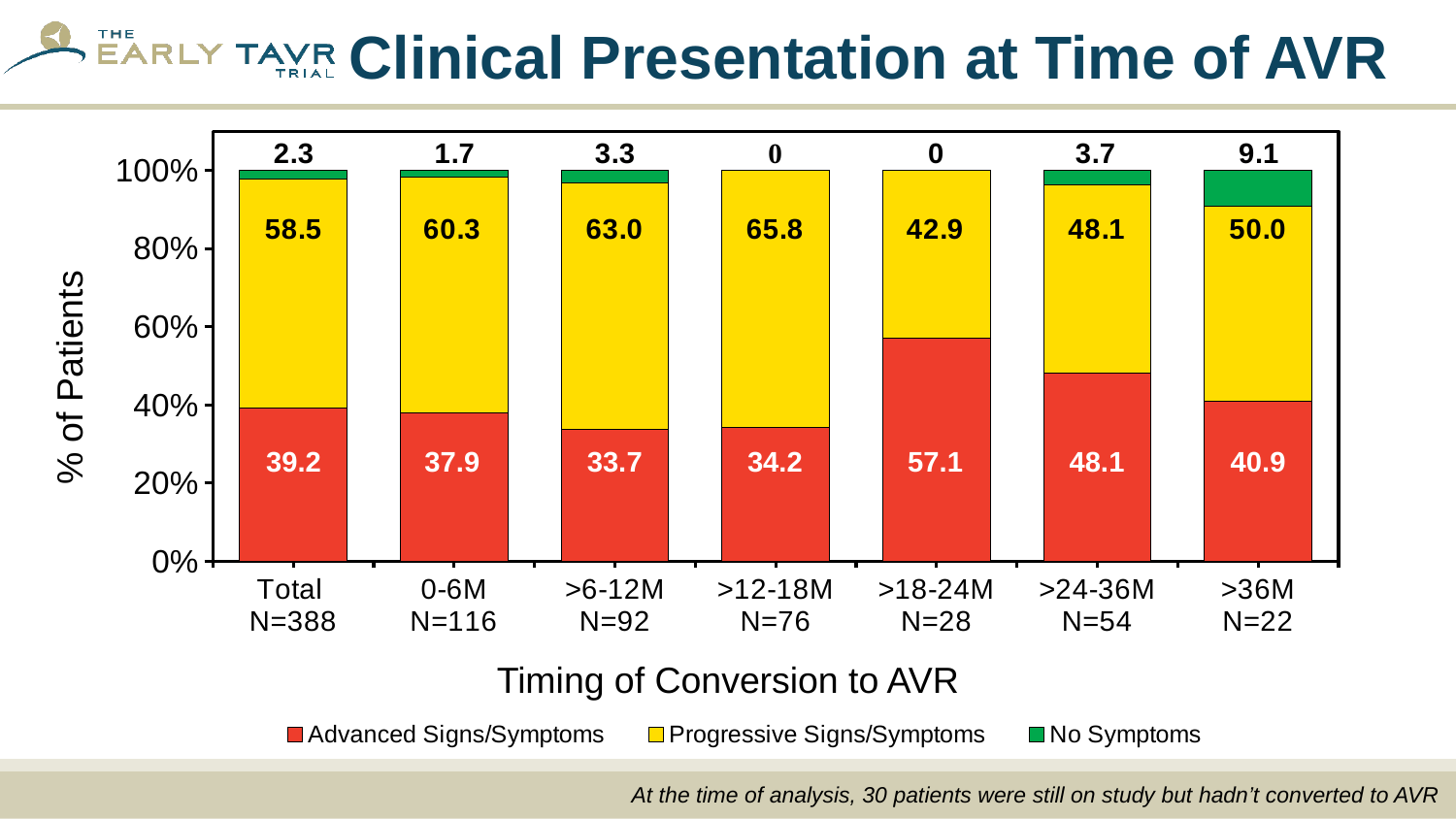
How many groups are shown on the x axis? 7 What is the value for Progressive Signs/Symptoms in the 0-6M group? 60.3 Which group has the lowest value for Advanced Signs/Symptoms? >6-12M Which group has the highest value for Progressive Signs/Symptoms? >12-18M What kind of chart is shown on the slide? Stacked bar chart How many series does the legend list? 3 What is the value for No Symptoms in the >36M group? 9.1 Which group has the highest value for Advanced Signs/Symptoms? >18-24M What is the value for Advanced Signs/Symptoms in the >18-24M group? 57.1 What is the difference between the Progressive Signs/Symptoms values for >12-18M and >18-24M? 22.9 Which is larger, the Advanced Signs/Symptoms value for 0-6M or for >36M? >36M What is the title of the x axis? Timing of Conversion to AVR